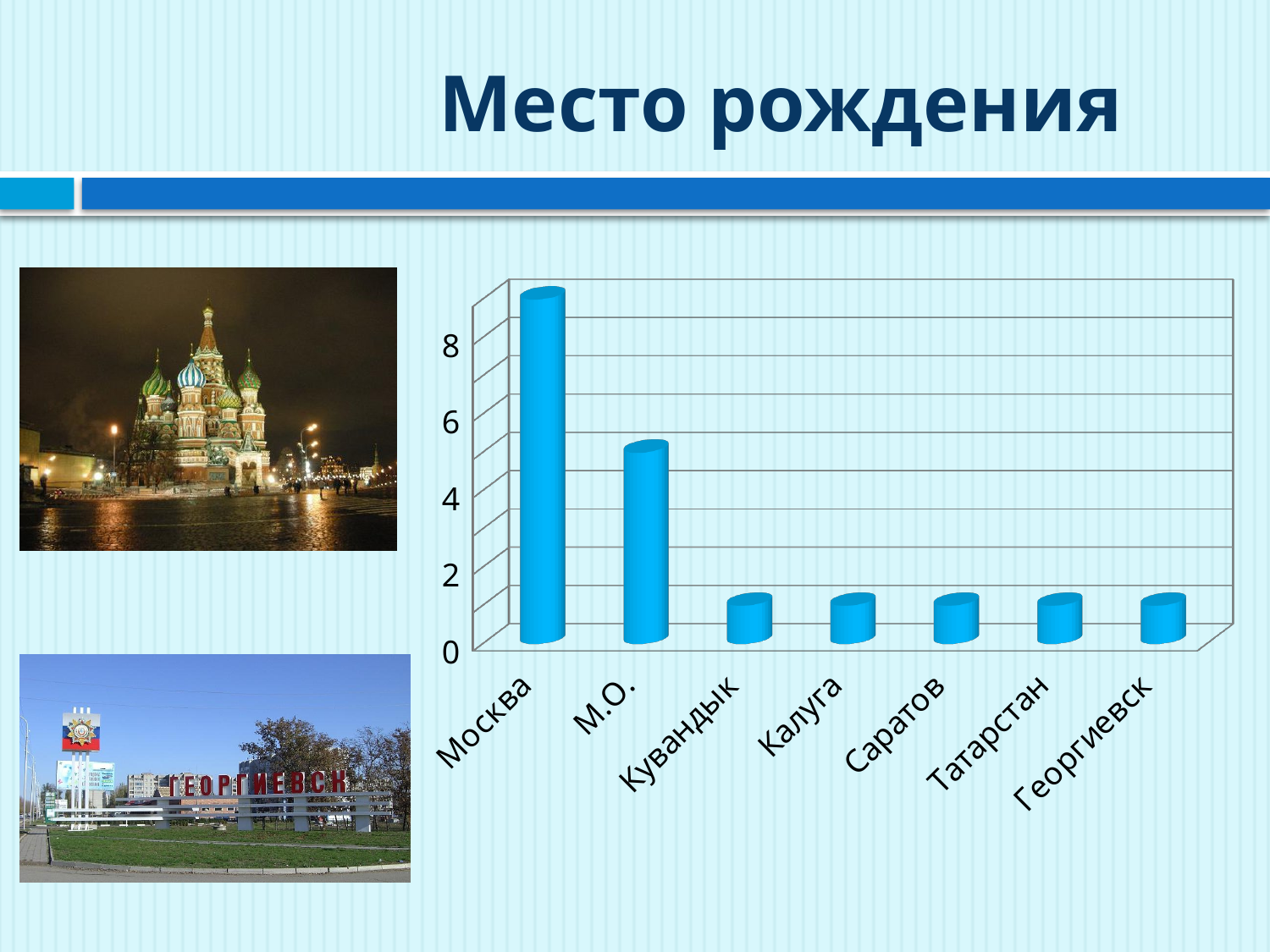
Which is larger, the value for Москва or the value for М.О.? Москва Which is larger, the value for М.О. or the value for Саратов? М.О. Is the value for Калуга greater or less than 2? less What is the title of the slide containing the chart? Место рождения Is the value for М.О. greater or less than 4? greater Which category has the highest bar in the chart? Москва Do the bar values generally rise or fall from left to right along the x axis? fall Is the value for Георгиевск greater or less than 2? less What kind of chart is shown on the slide? bar chart How many categories are shown on the x axis of the chart? 7